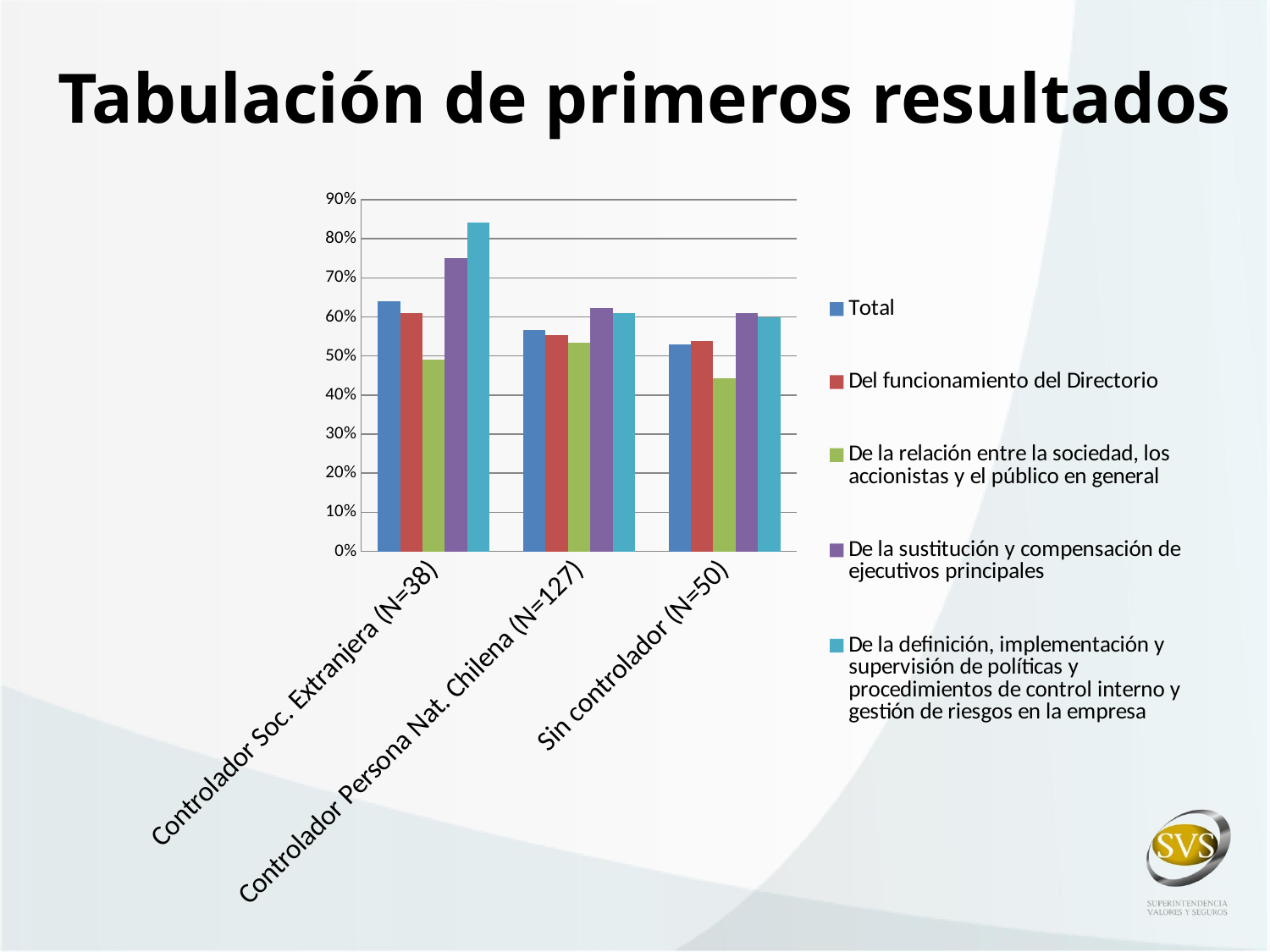
Is the value of 'De la definición, implementación y supervisión de políticas y procedimientos de control interno y gestión de riesgos en la empresa' for 'Controlador Soc. Extranjera (N=38)' greater or less than 80%? greater Within the category 'Controlador Soc. Extranjera (N=38)', which series has the lowest value? De la relación entre la sociedad, los accionistas y el público en general What kind of chart is shown on the slide? Bar chart What colour represents the 'Total' series in the chart? Blue What is the title of the slide containing the chart? Tabulación de primeros resultados Which category has the highest value for the series 'De la definición, implementación y supervisión de políticas y procedimientos de control interno y gestión de riesgos en la empresa'? Controlador Soc. Extranjera (N=38) How many series does the chart's legend list? 5 Is the value of 'De la relación entre la sociedad, los accionistas y el público en general' for 'Sin controlador (N=50)' greater or less than 50%? less Is the value of 'De la sustitución y compensación de ejecutivos principales' for 'Controlador Soc. Extranjera (N=38)' greater or less than 70%? greater How many categories are shown on the x axis of the chart? 3 For the series 'De la sustitución y compensación de ejecutivos principales', which is larger: the value for 'Controlador Soc. Extranjera (N=38)' or for 'Controlador Persona Nat. Chilena (N=127)'? Controlador Soc. Extranjera (N=38) Which category has the lowest value for the series 'De la relación entre la sociedad, los accionistas y el público en general'? Sin controlador (N=50)